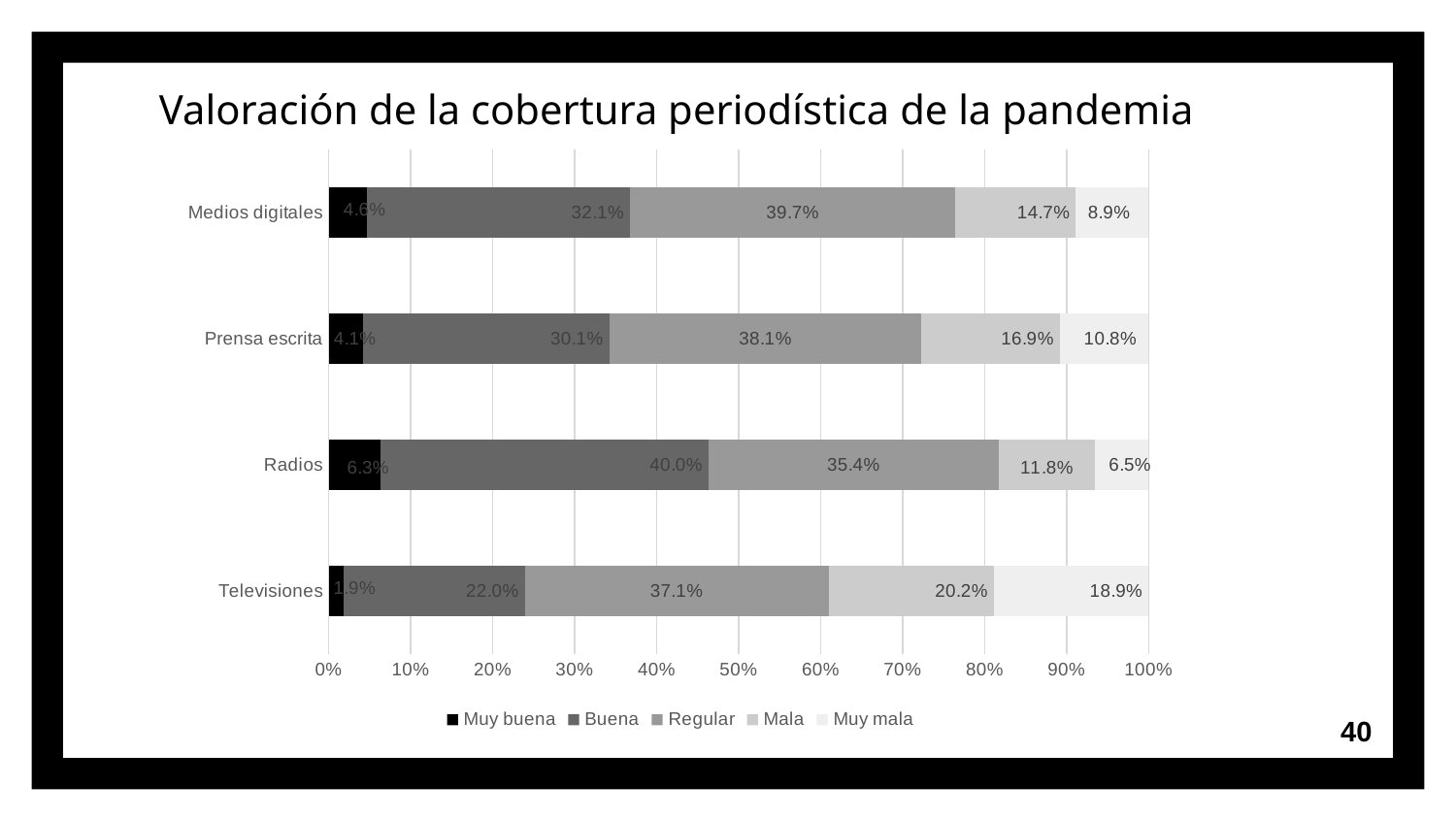
What is the difference between the Mala value for Televisiones and the Mala value for Radios? 8.4 percentage points Which media category has the lowest Muy buena value? Televisiones What is the Muy buena value for Radios? 6.3% What percentage of respondents rated the coverage by Medios digitales as Regular? 39.7% Which media category has the highest Muy mala value? Televisiones What is the Muy mala value for Televisiones? 18.9% What is the title of the chart? Valoración de la cobertura periodística de la pandemia Which is larger: the Regular value for Prensa escrita or the Regular value for Radios? Prensa escrita How many media categories are shown on the chart? 4 Which media category has the highest Buena value? Radios What kind of chart is shown on the slide? Stacked bar chart How many series does the legend list? 5